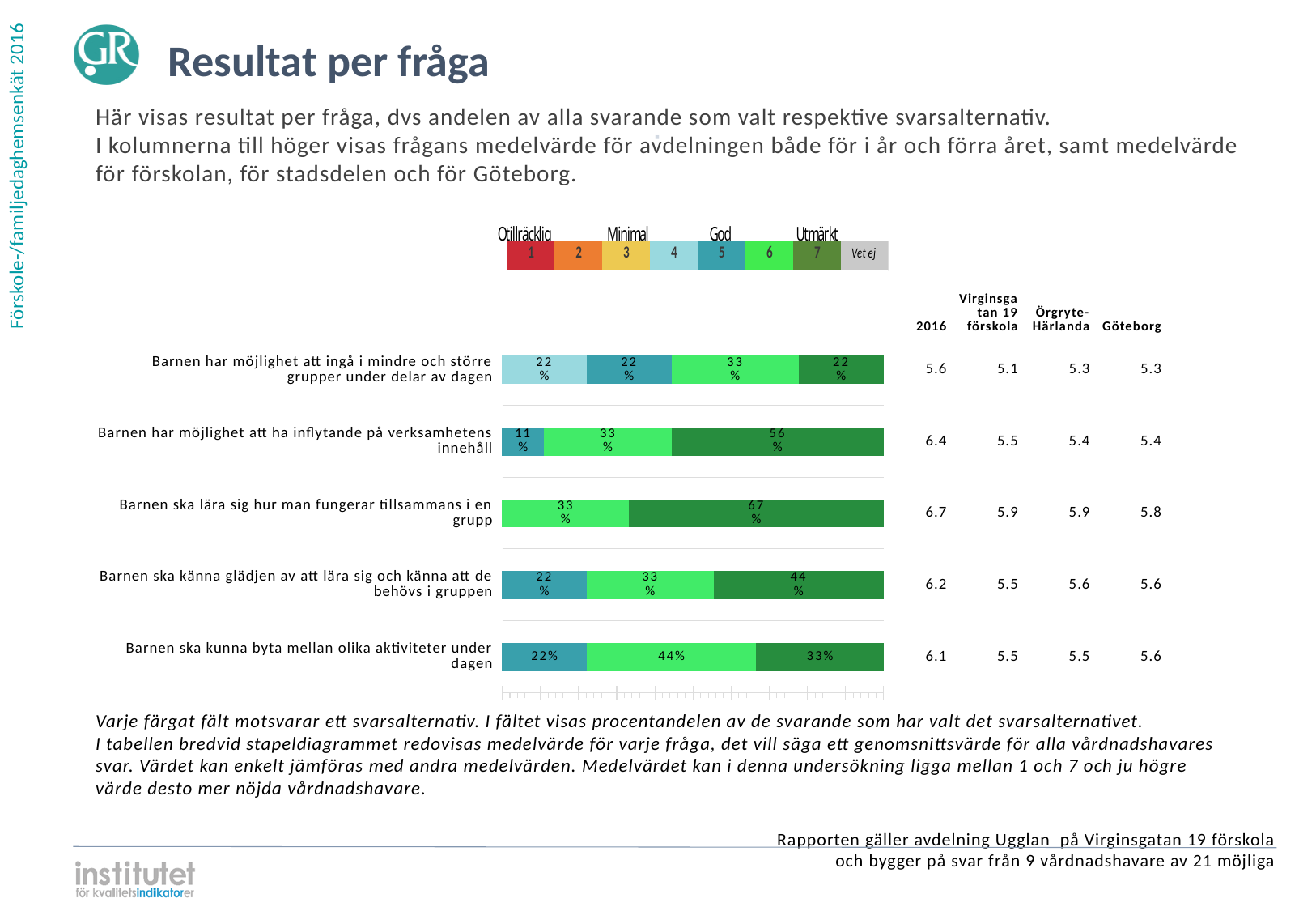
How many questions (categories) are plotted in the bar chart? 5 For "Barnen ska känna glädjen av att lära sig och känna att de behövs i gruppen", which answer has a larger share: 6 or 7? 7 What is the title of the slide containing the chart? Resultat per fråga What is the difference between the share choosing answer 7 and the share choosing answer 6 for "Barnen ska lära sig hur man fungerar tillsammans i en grupp"? 34% What percentage of respondents chose answer 7 for "Barnen ska lära sig hur man fungerar tillsammans i en grupp"? 67% What percentage of respondents chose answer 5 for "Barnen har möjlighet att ha inflytande på verksamhetens innehåll"? 11% What kind of chart is shown on the slide? Stacked bar chart What percentage of respondents chose answer 6 for "Barnen ska kunna byta mellan olika aktiviteter under dagen"? 44% Which question has the largest share of respondents choosing answer 7? Barnen ska lära sig hur man fungerar tillsammans i en grupp How many entries does the legend above the chart list? 8 Which question has the smallest share of respondents choosing answer 7? Barnen har möjlighet att ingå i mindre och större grupper under delar av dagen What is the combined share of answers 6 and 7 for "Barnen har möjlighet att ha inflytande på verksamhetens innehåll"? 89%